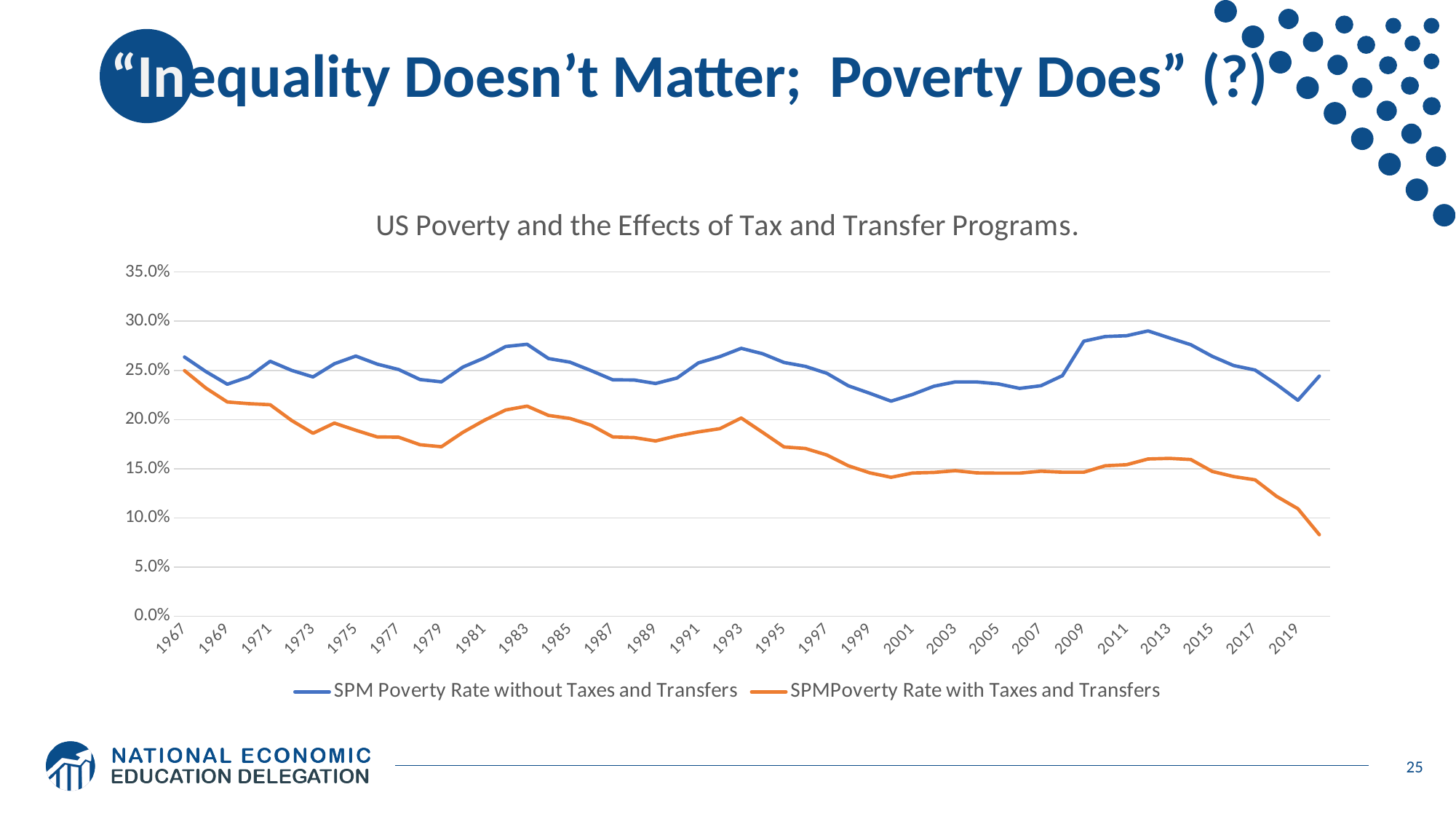
For SPM Poverty Rate without Taxes and Transfers, which year has the larger value: 1983 or 2001? 1983 Which series is drawn in orange? SPMPoverty Rate with Taxes and Transfers What kind of chart is shown on the slide? line chart Is the value for SPM Poverty Rate with Taxes and Transfers in 1979 greater or less than 20.0%? less Is the value for SPM Poverty Rate with Taxes and Transfers in 1967 greater or less than 20.0%? greater What is the title of the chart? US Poverty and the Effects of Tax and Transfer Programs. How many series does the legend list? 2 How many year labels are shown on the x axis? 27 In 1993, which series has the higher value: SPM Poverty Rate without Taxes and Transfers or SPM Poverty Rate with Taxes and Transfers? SPM Poverty Rate without Taxes and Transfers Does the SPM Poverty Rate with Taxes and Transfers line generally rise or fall from 1967 to the end of the series? fall Is the value for SPM Poverty Rate without Taxes and Transfers in 2001 greater or less than 25.0%? less